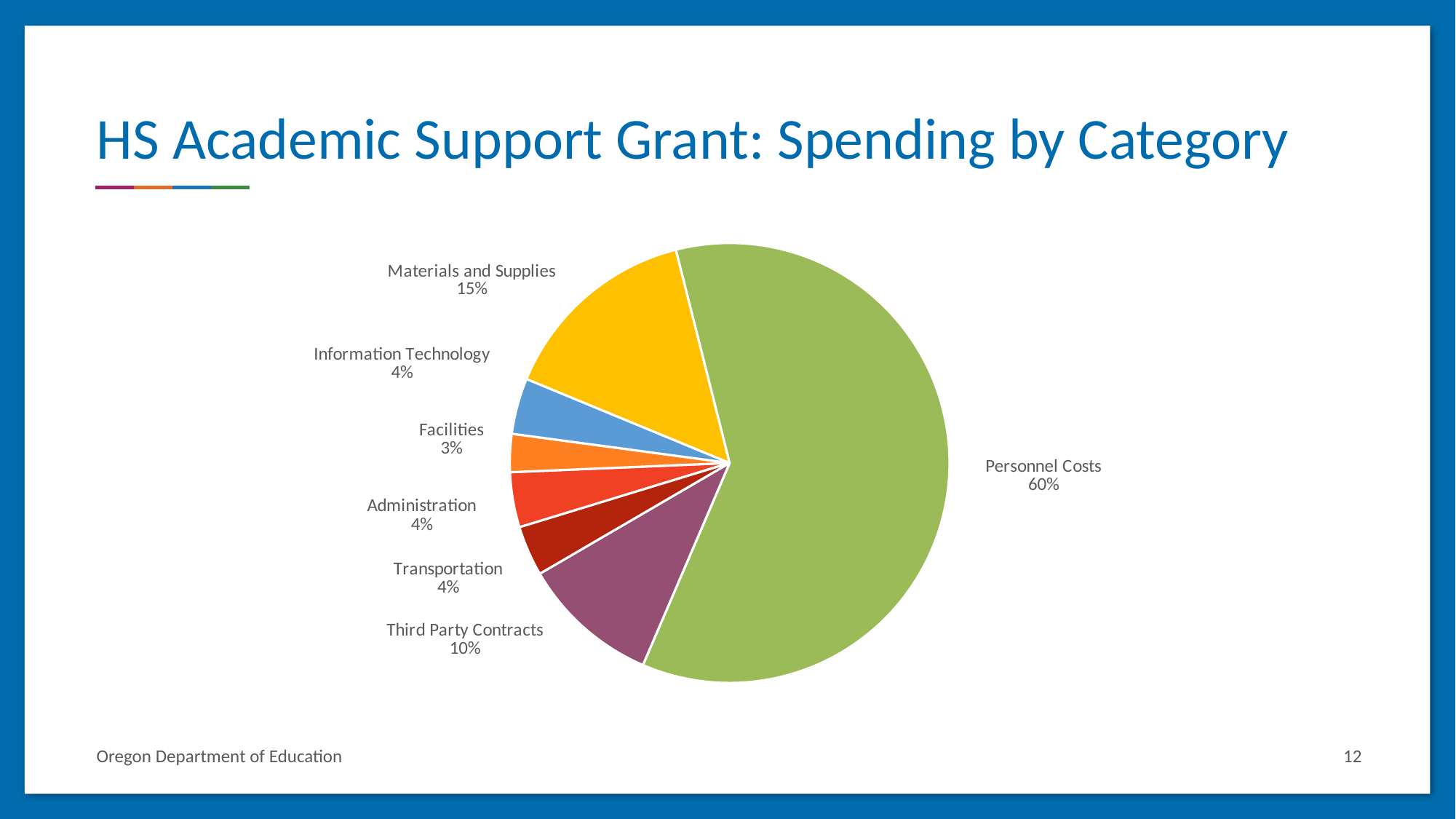
How many categories are shown in the pie chart? 7 What kind of chart is shown on the slide? pie chart What colour is the Personnel Costs slice? green Which is larger, the share for Third Party Contracts or the share for Materials and Supplies? Materials and Supplies Which category has the smallest share of spending? Facilities What share of spending goes to Materials and Supplies? 15% What is the difference between the Personnel Costs share and the Materials and Supplies share? 45% What is the title of the chart on the slide? HS Academic Support Grant: Spending by Category Which category has the largest share of spending? Personnel Costs What share of spending goes to Facilities? 3% What share of spending goes to Third Party Contracts? 10% What share of spending goes to Personnel Costs? 60%